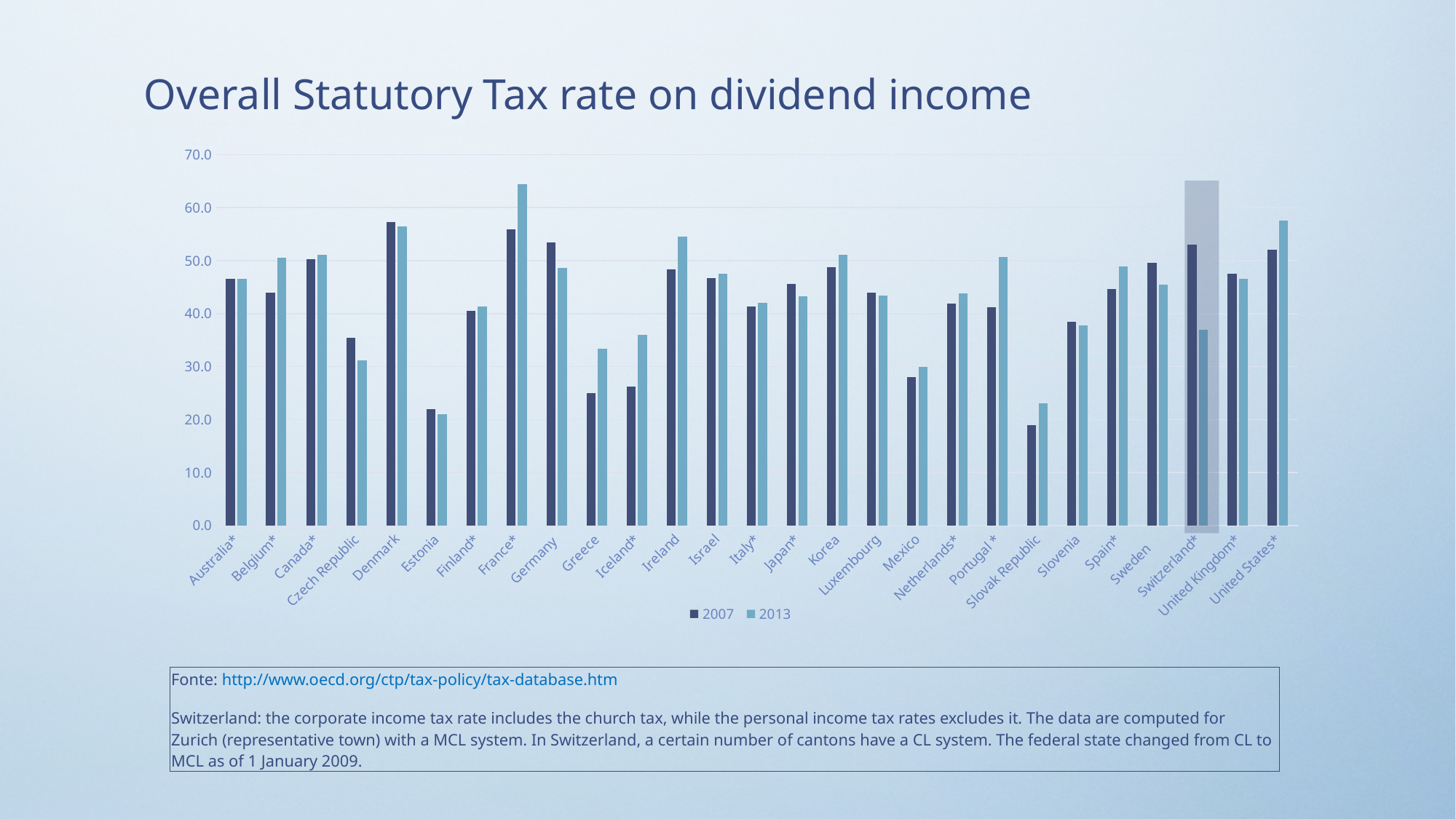
How many countries are shown on the x axis? 27 For Greece, which is larger, the 2007 value or the 2013 value? 2013 Which country has the lowest value for 2013? Estonia Which country has the lowest value for 2007? Slovak Republic Is the 2007 value for Slovak Republic greater or less than 20.0? less What is the title of the chart? Overall Statutory Tax rate on dividend income How many series does the legend list? 2 Is the 2013 value for France* greater or less than 60.0? greater Is the 2013 value for Switzerland* greater or less than 40.0? less Which country has the highest value for 2013? France* What kind of chart is shown on the slide? Bar chart For Switzerland*, which is larger, the 2007 value or the 2013 value? 2007